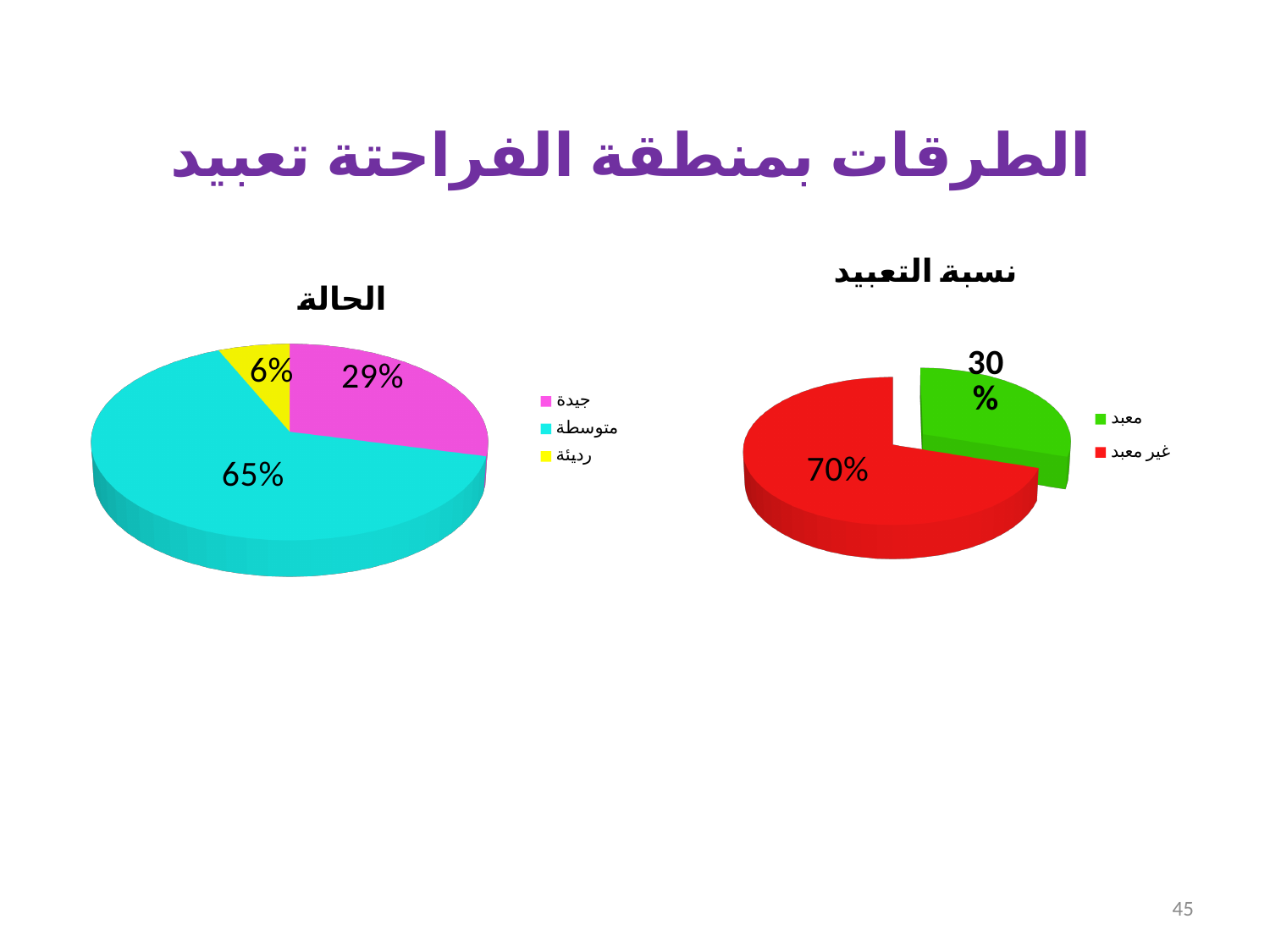
What kind of chart is the chart titled "نسبة التعبيد"? Pie chart In the chart titled "الحالة", which category has the smallest share? رديئة In the chart titled "الحالة", what percentage is shown for "جيدة"? 29% In the chart titled "نسبة التعبيد", which category is larger, "معبد" or "غير معبد"? غير معبد In the chart titled "نسبة التعبيد", what percentage is shown for "غير معبد"? 70% In the chart titled "نسبة التعبيد", what colour is the slice for "معبد"? Green In the chart titled "الحالة", which category has the largest share? متوسطة In the chart titled "الحالة", what percentage is shown for "رديئة"? 6% In the chart titled "الحالة", what is the difference between the shares of "متوسطة" and "جيدة"? 36% In the chart titled "نسبة التعبيد", what percentage is shown for "معبد"? 30% In the chart titled "الحالة", how many categories does the legend list? 3 In the chart titled "الحالة", what percentage is shown for "متوسطة"? 65%